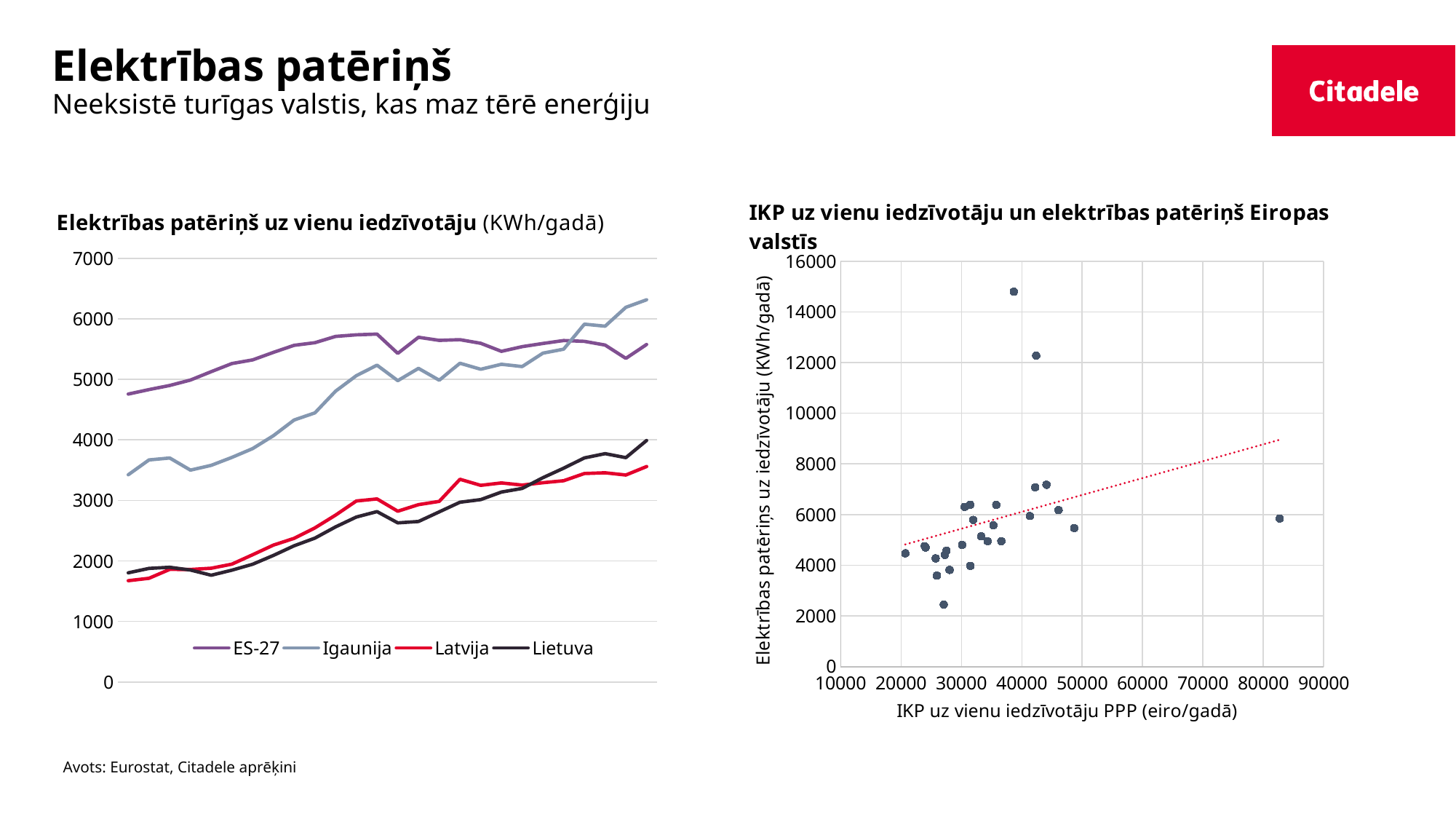
In the left chart, which series has the highest value at the right end of the x axis? Igaunija In the left chart, is the first value for Lietuva greater or less than 2000? less What kind of chart is the left chart, 'Elektrības patēriņš uz vienu iedzīvotāju (KWh/gadā)'? line chart What kind of chart is the right chart, 'IKP uz vienu iedzīvotāju un elektrības patēriņš Eiropas valstīs'? scatter chart In the right chart, is the highest plotted point greater or less than 14000 KWh/gadā? greater In the left chart, is the final value for Igaunija greater or less than 6000? greater In the left chart, do the values for Lietuva generally rise or fall along the x axis? rise In the right chart, what is the label of the x axis? IKP uz vienu iedzīvotāju PPP (eiro/gadā) In the left chart, how many series does the legend list? 4 In the left chart, at the right end of the x axis, which is larger: Igaunija or ES-27? Igaunija In the left chart, which series has the lowest value at the right end of the x axis? Latvija